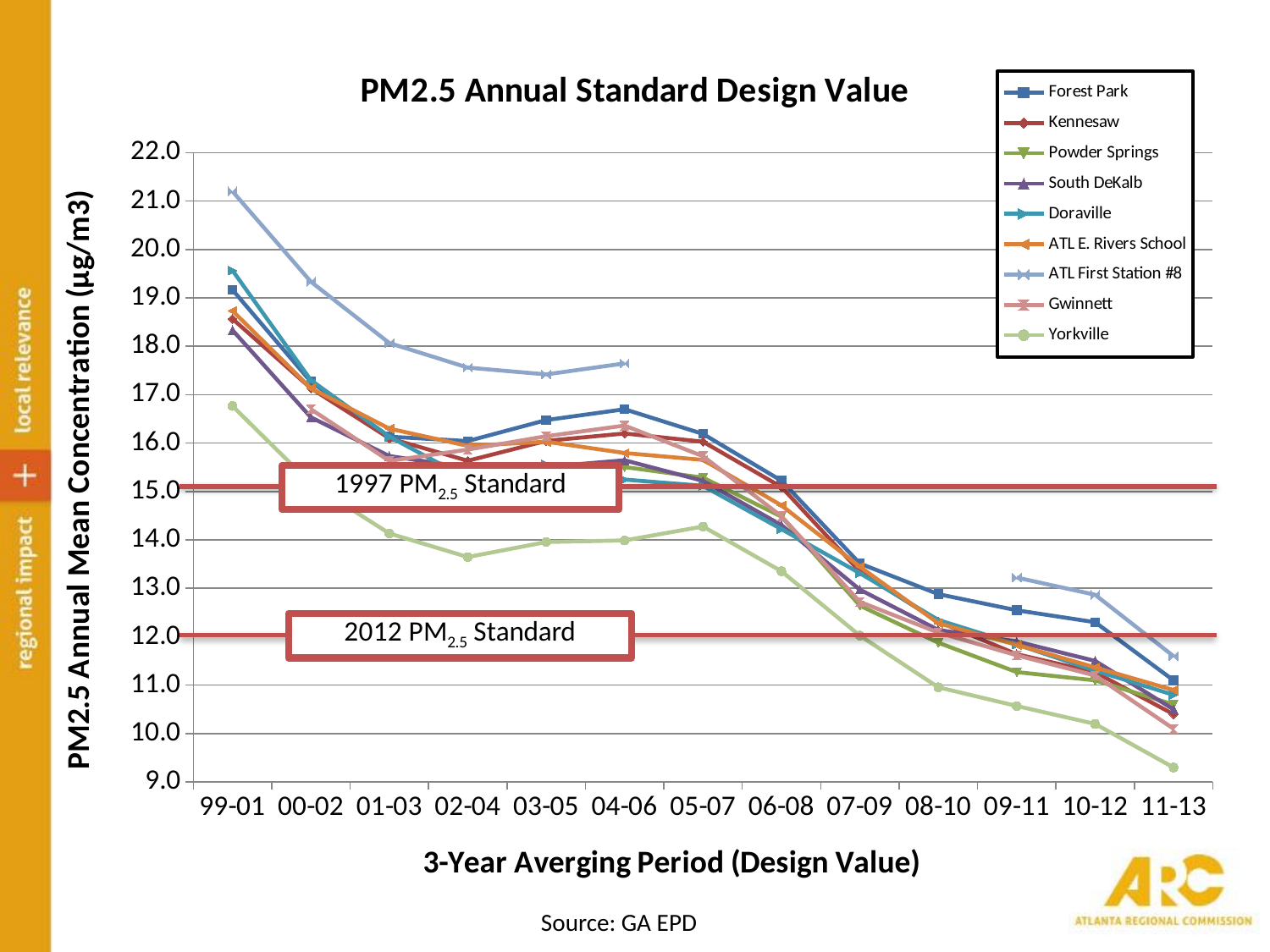
Is the value for ATL First Station #8 in 99-01 greater or less than 20.0? greater What is the title of the chart? PM2.5 Annual Standard Design Value Overall, do the PM2.5 design values rise or fall from 99-01 to 11-13? Fall What kind of chart is shown on the slide? Line chart Which monitoring site has the highest value in the 99-01 period? ATL First Station #8 Which monitoring site has the lowest value in the 11-13 period? Yorkville Is the value for Yorkville in 02-04 greater or less than 14.0? less Which monitoring site has the lowest value in the 99-01 period? Yorkville In the 05-07 period, which is larger: the value for Forest Park or the value for Yorkville? Forest Park Is the value for Yorkville in 11-13 greater or less than 10.0? less How many series does the legend list? 9 How many 3-year averaging periods are shown on the x axis? 13